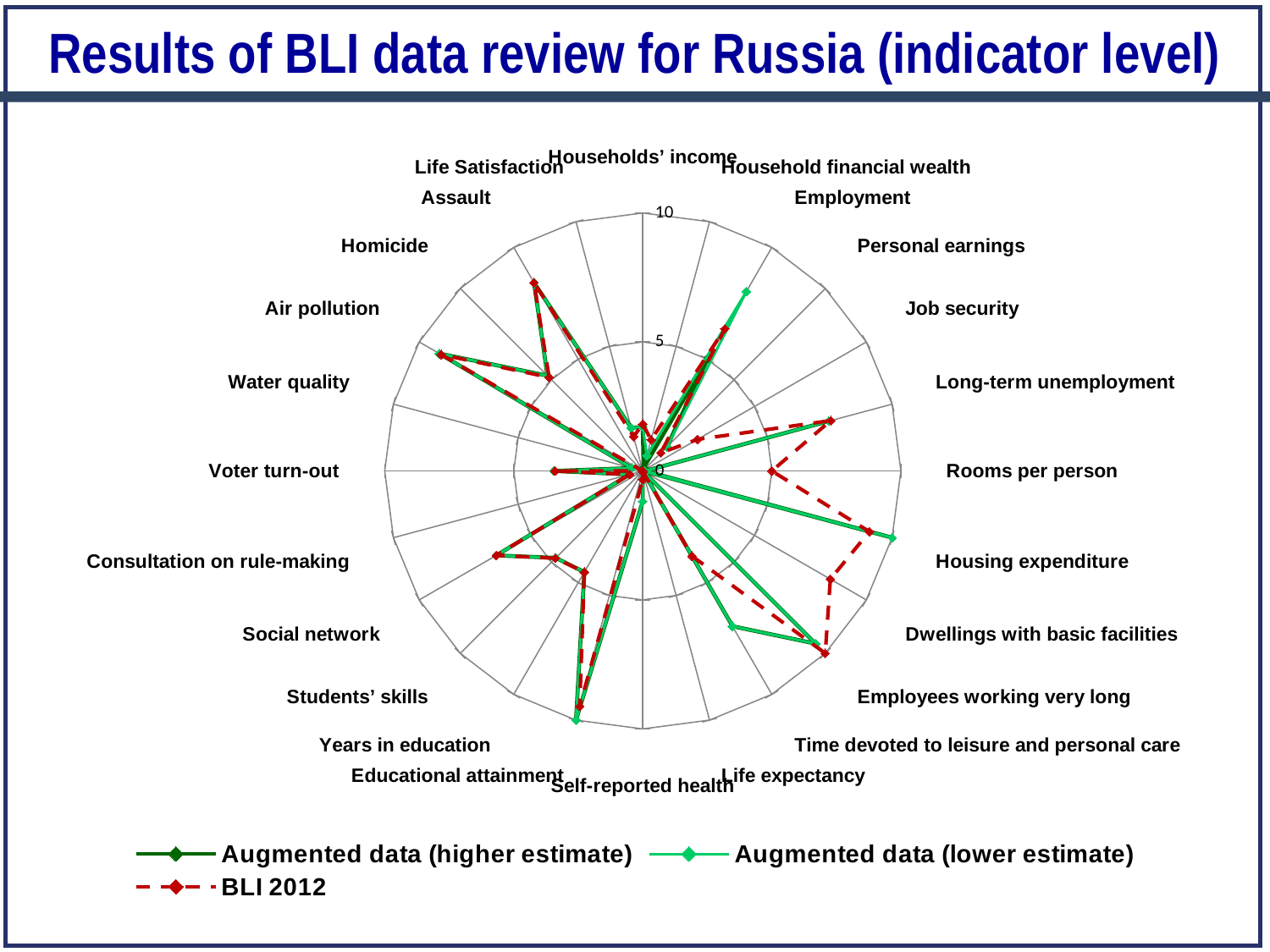
Which series is drawn with a dashed red line? BLI 2012 Is the value for Housing expenditure greater or less than 5? greater Is the value for Water quality greater or less than 5? less Is the value for Voter turn-out greater or less than 5? less How many indicator categories are plotted around the radar chart? 24 How many series does the legend list? 3 What kind of chart is shown on the slide? Radar chart What is the title of the slide? Results of BLI data review for Russia (indicator level)